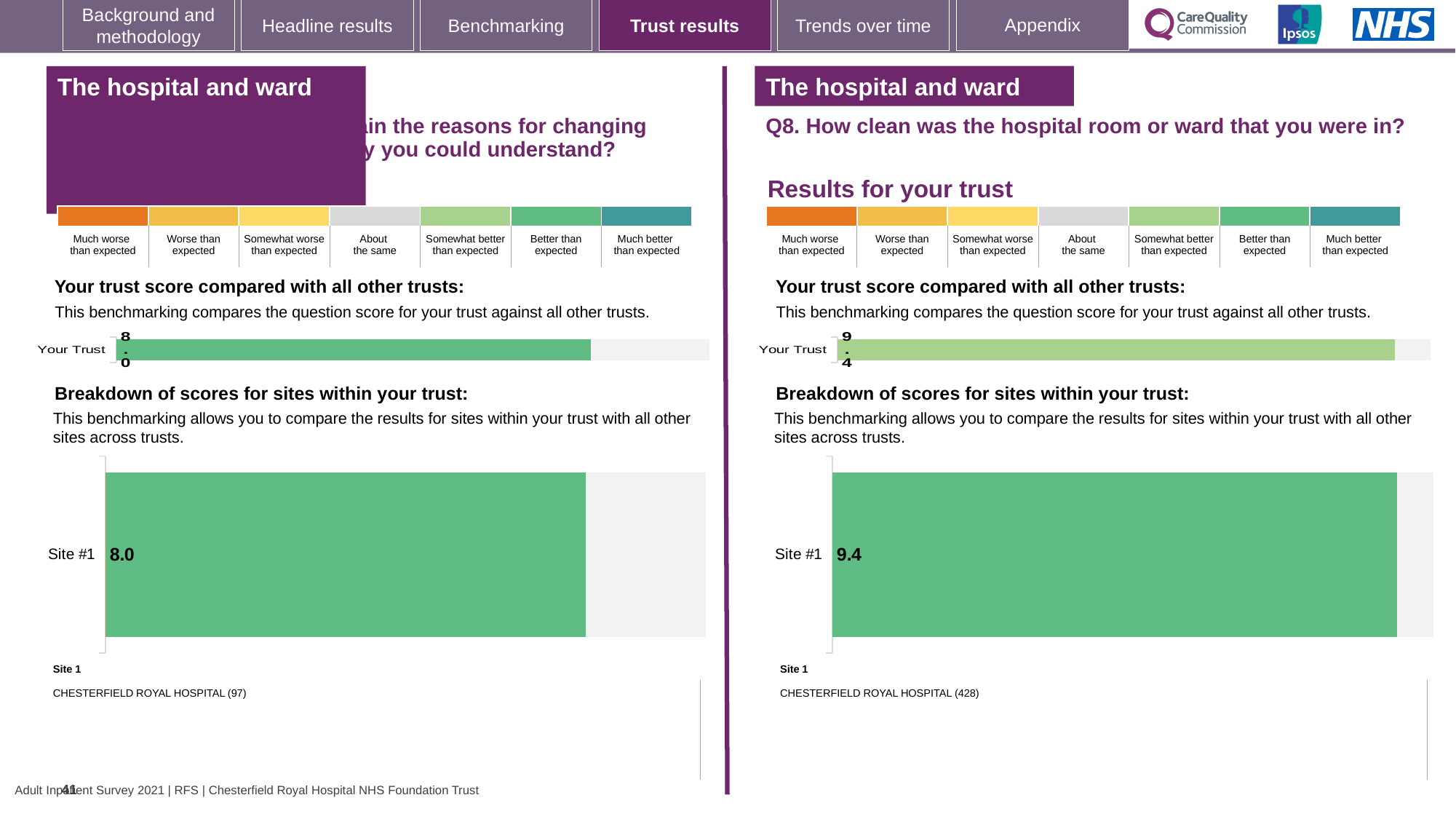
What kind of chart is used to show the Site #1 score in the right-hand breakdown chart? Bar chart How many sites are shown in the right-hand 'Breakdown of scores for sites within your trust' chart for Q8? 1 In the right-hand 'Breakdown of scores for sites within your trust' chart (Q8), what is the score for Site #1? 9.4 On the right-hand chart for Q8 (How clean was the hospital room or ward), what is the score shown for Your Trust? 9.4 In the left-hand 'Breakdown of scores for sites within your trust' chart, what is the score for Site #1? 8.0 Which hospital is listed as Site 1 beneath the left-hand breakdown chart? CHESTERFIELD ROYAL HOSPITAL (97) Which hospital is listed as Site 1 beneath the right-hand Q8 breakdown chart? CHESTERFIELD ROYAL HOSPITAL (428) How many sites are shown in the left-hand 'Breakdown of scores for sites within your trust' chart? 1 Which is larger: the Your Trust score on the left-hand chart or the Your Trust score on the right-hand Q8 chart? The right-hand Q8 chart On the left-hand side of the slide, what is the score shown for Your Trust in the trust comparison bar? 8.0 What is the difference between the Site #1 score on the right-hand Q8 chart and the Site #1 score on the left-hand chart? 1.4